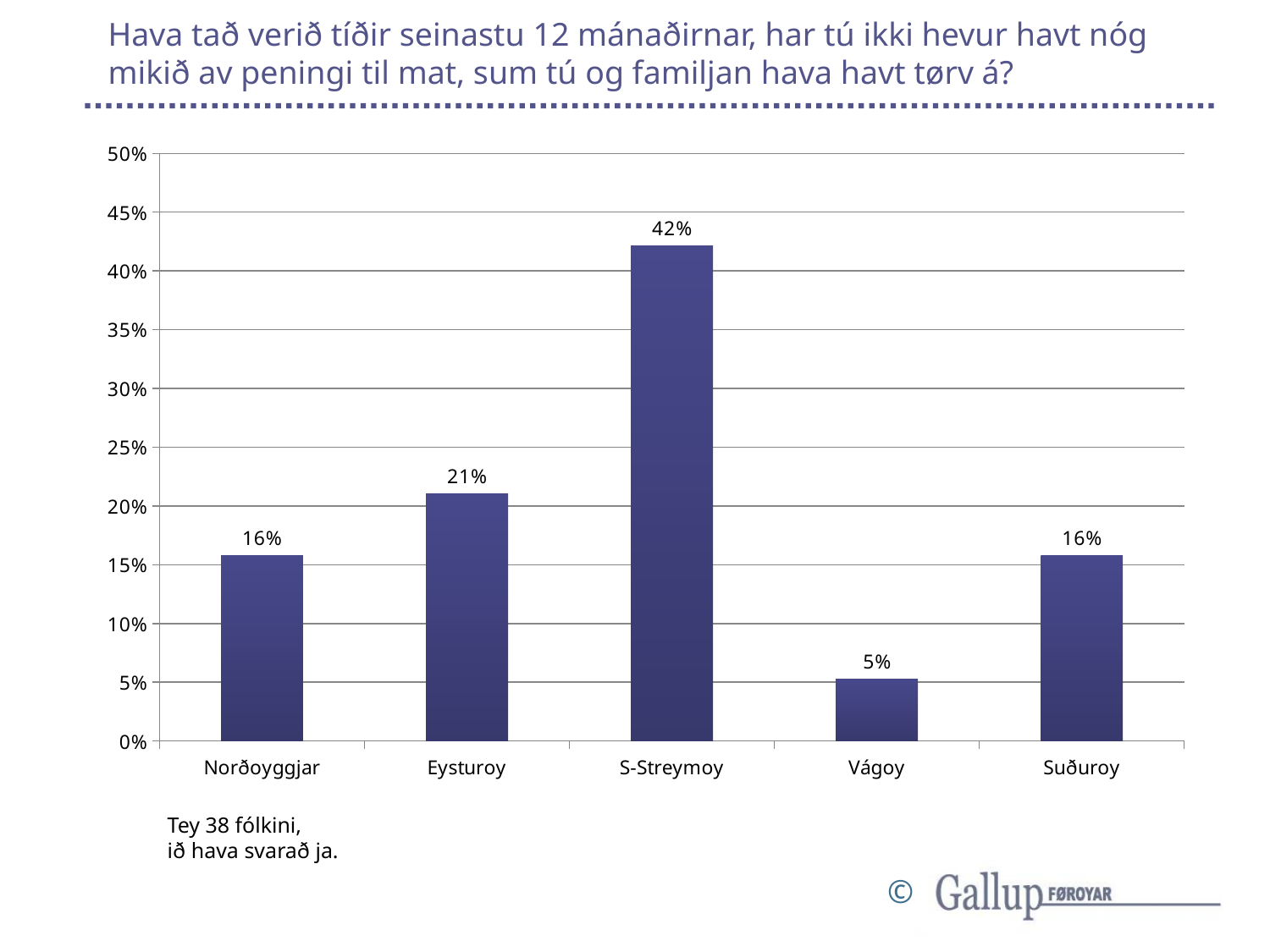
Is the value for S-Streymoy greater or less than 40%? greater What is the value for Norðoyggjar? 16% Which is larger, the value for Eysturoy or the value for Suðuroy? Eysturoy What is the value for Vágoy? 5% What kind of chart is shown on the slide? bar chart What is the value for S-Streymoy? 42% How many categories are shown on the x axis? 5 According to the note below the chart, how many people answered yes? 38 What is the difference between the values for S-Streymoy and Eysturoy? 21% What is the value for Eysturoy? 21% Which category has the highest value? S-Streymoy Which category has the lowest value? Vágoy